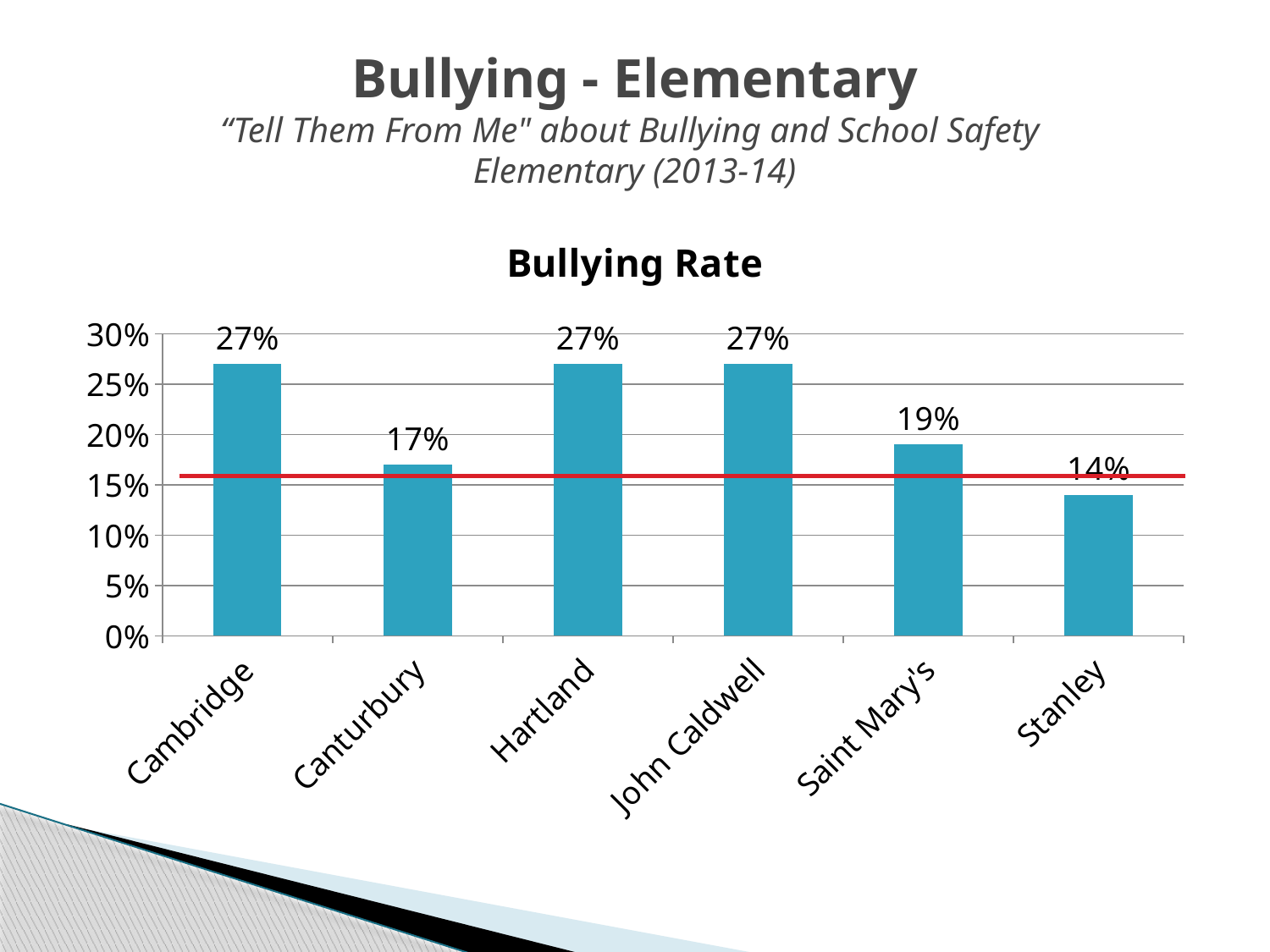
What is the difference between the bullying rates of Hartland and Stanley? 13% What is the title of the chart? Bullying Rate What is the bullying rate for Saint Mary's? 19% Is the value for Stanley greater or less than 15%? less How many schools are shown on the chart? 6 What is the bullying rate for Canturbury? 17% What kind of chart is shown on the slide? bar chart What is the bullying rate for Stanley? 14% What is the difference between the bullying rates of Saint Mary's and Canturbury? 2% Which school has the lowest bullying rate? Stanley What is the bullying rate for Cambridge? 27% Which has a higher bullying rate, John Caldwell or Saint Mary's? John Caldwell